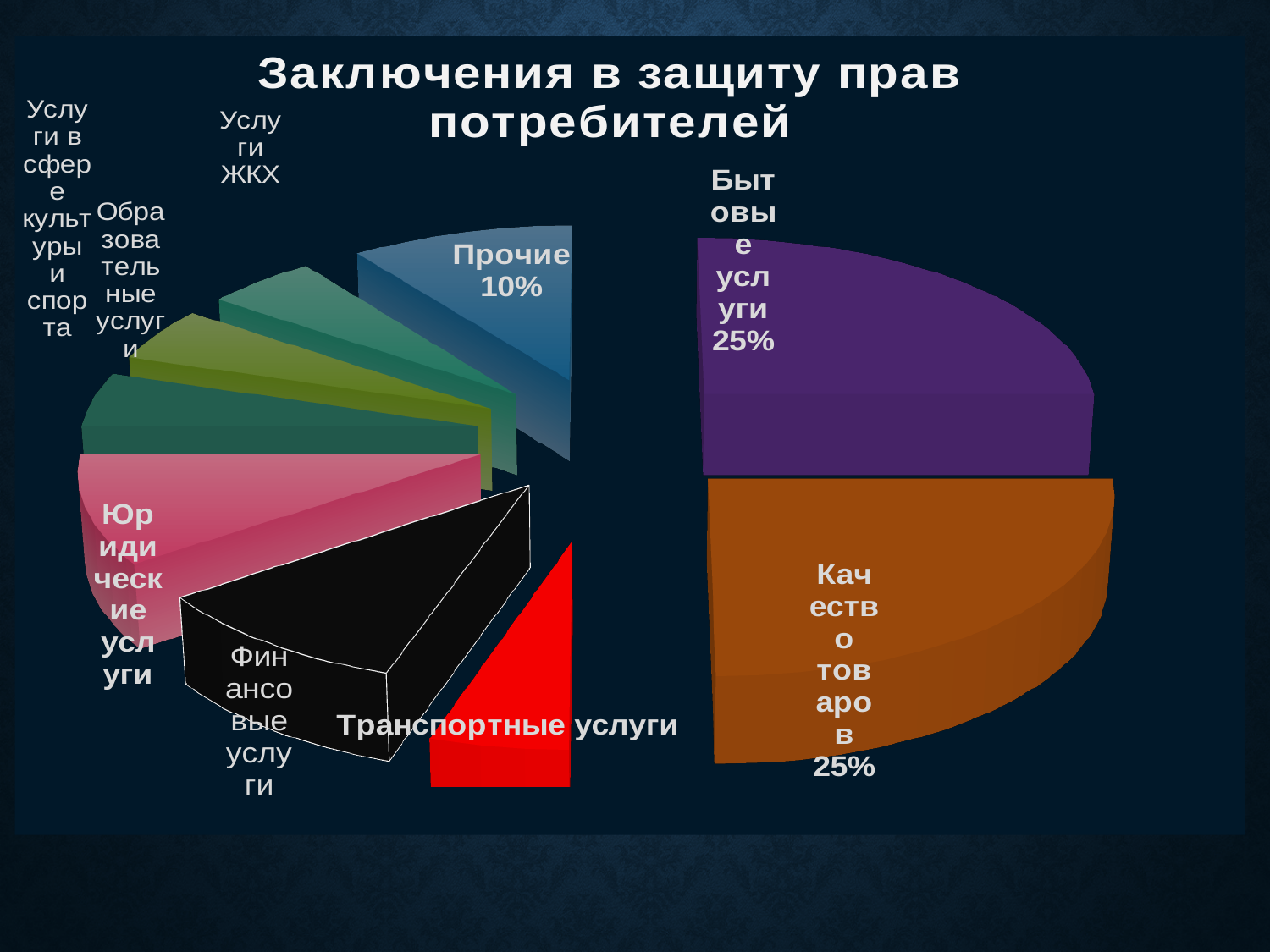
Which is larger, the share for Бытовые услуги or the share for Прочие? Бытовые услуги What is the difference in percentage points between Бытовые услуги and Прочие? 15 What percentage is shown for Качество товаров? 25% What share of the pie does the Прочие slice represent? 10% What colour is the Транспортные услуги slice? red What percentage is shown for Бытовые услуги? 25% Which is larger, the share for Качество товаров or the share for Прочие? Качество товаров What kind of chart is shown on the slide? pie chart What is the title of the chart? Заключения в защиту прав потребителей How many categories (slices) are labelled in the pie chart? 9 What percentage is shown for the Прочие slice? 10%